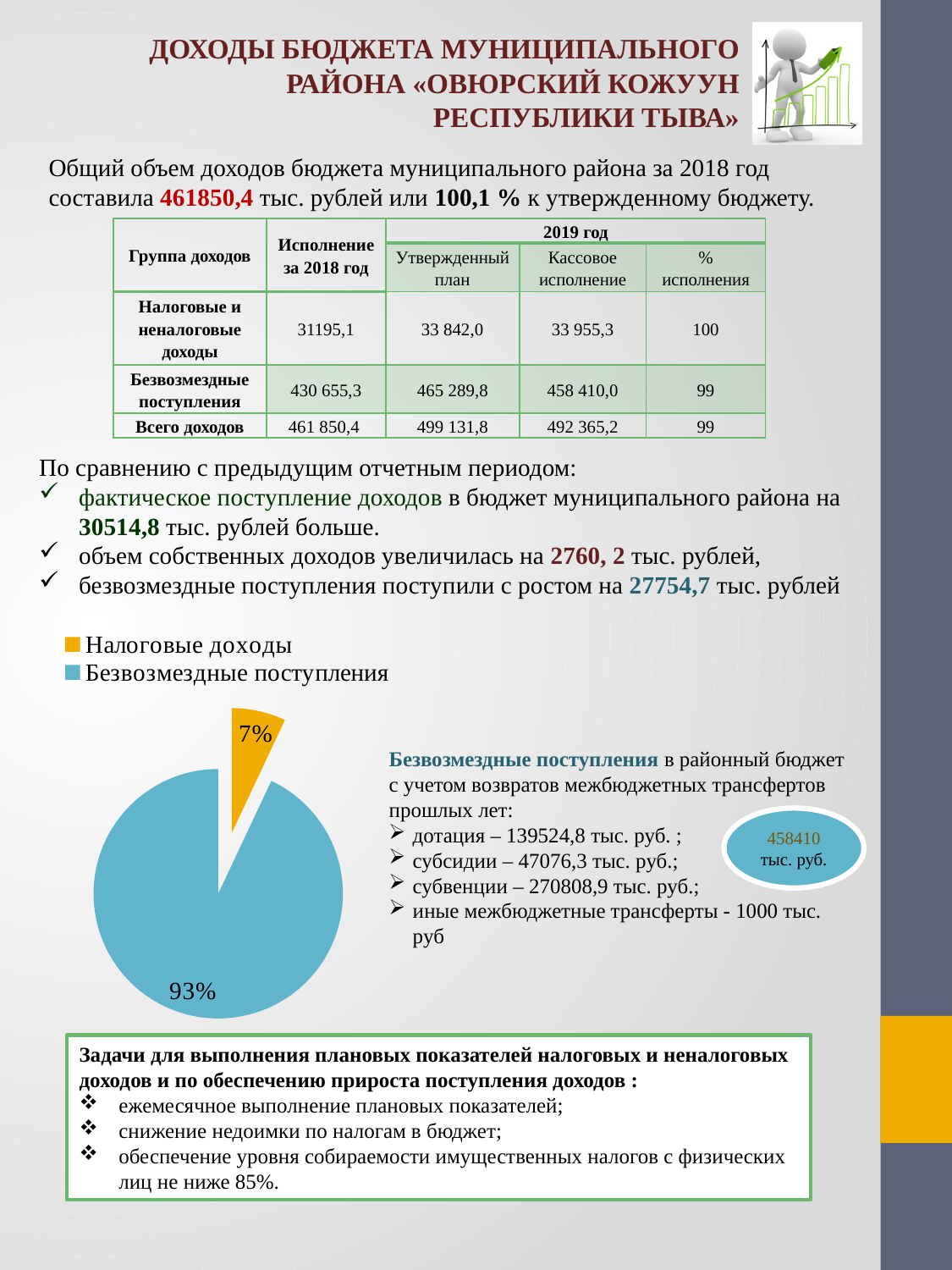
Which slice of the pie chart is the largest? Безвозмездные поступления What is the difference in percentage points between the «Безвозмездные поступления» slice and the «Налоговые доходы» slice? 86 percentage points What share of the pie does «Безвозмездные поступления» represent? 93% How many slices does the pie chart have? 2 What kind of chart is shown on the slide? pie chart Which slice of the pie chart is the smallest? Налоговые доходы What share of the pie does «Налоговые доходы» represent? 7% Which is larger in the pie chart: «Налоговые доходы» or «Безвозмездные поступления»? Безвозмездные поступления What colour is the «Безвозмездные поступления» slice in the pie chart? blue How many entries does the legend of the pie chart list? 2 What colour is the «Налоговые доходы» slice in the pie chart? orange